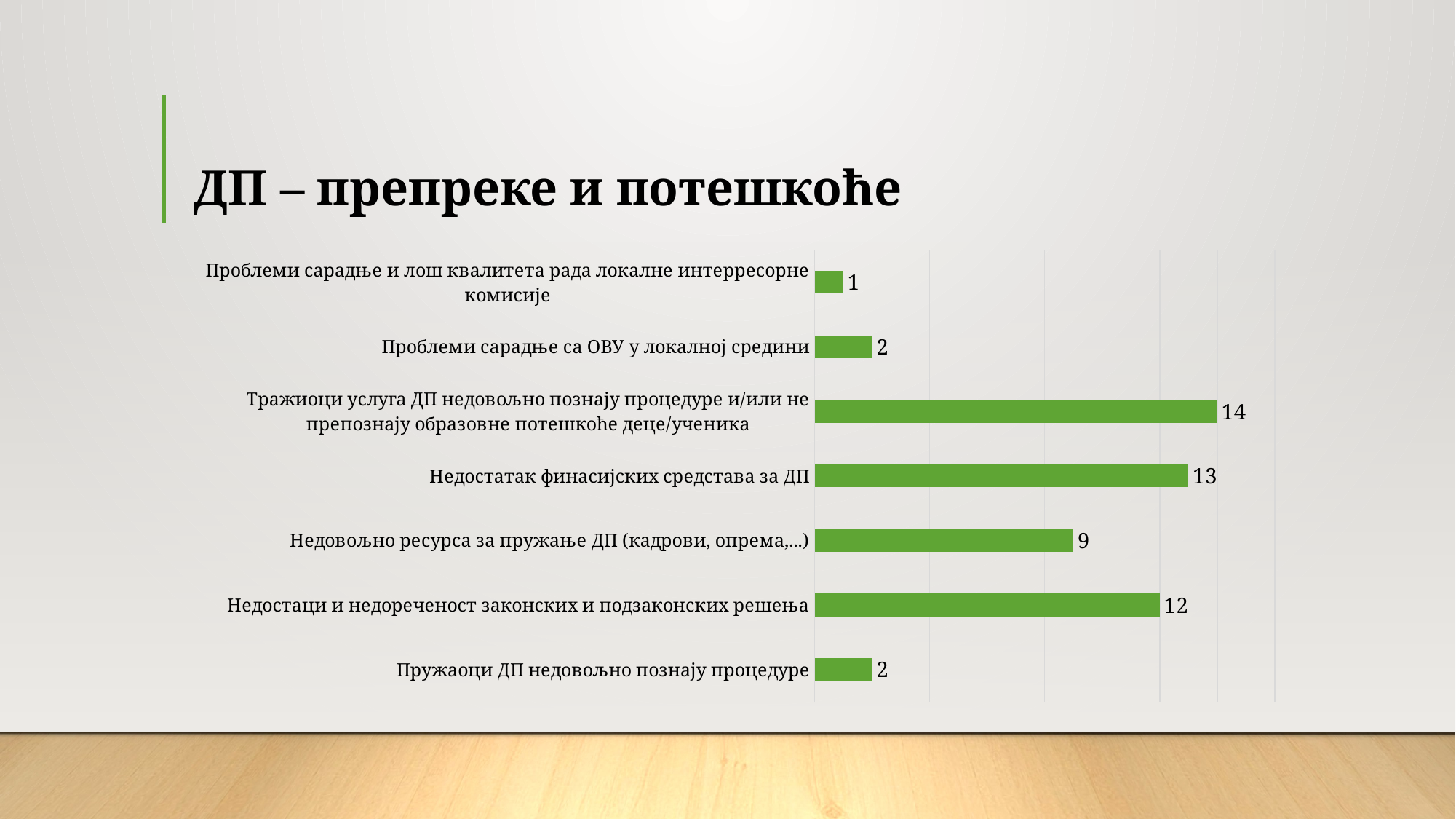
What value is shown for "Недостатак финасијских средстава за ДП"? 13 What colour are the bars in the chart? Green What kind of chart is shown on the slide? Bar chart What is the difference between the values for "Тражиоци услуга ДП недовољно познају процедуре и/или не препознају образовне потешкоће деце/ученика" and "Недовољно ресурса за пружање ДП (кадрови, опрема,...)"? 5 Which category has the highest value? Тражиоци услуга ДП недовољно познају процедуре и/или не препознају образовне потешкоће деце/ученика Which is larger: the value for "Недостатак финасијских средстава за ДП" or the value for "Недостаци и недореченост законских и подзаконских решења"? Недостатак финасијских средстава за ДП What is the title of the slide? ДП – препреке и потешкоће How many categories does the chart show? 7 What value is shown for "Проблеми сарадње са ОВУ у локалној средини"? 2 What value is shown for "Недостаци и недореченост законских и подзаконских решења"? 12 Which category has the lowest value? Проблеми сарадње и лош квалитета рада локалне интерресорне комисије What value is shown for "Недовољно ресурса за пружање ДП (кадрови, опрема,...)"? 9